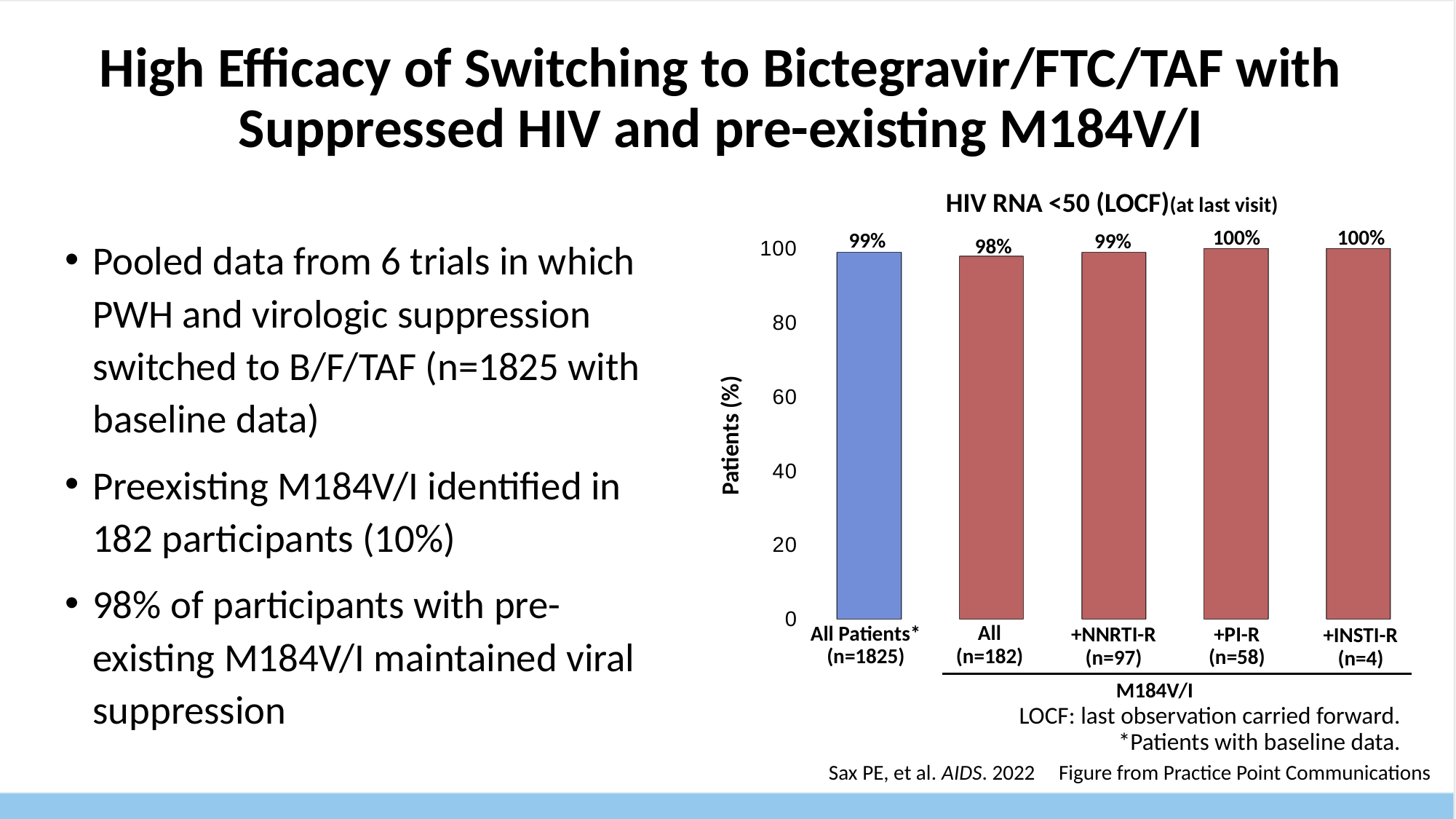
What is the value for the +INSTI-R (n=4) group? 100% Which category has the lowest value? All (n=182) What is the difference between the values for +PI-R (n=58) and All (n=182)? 2% What is the value for the +NNRTI-R (n=97) group? 99% What is the value for All Patients (n=1825)? 99% What is the value for the +PI-R (n=58) group? 100% What is the value for the All (n=182) M184V/I group? 98% Is the value for +NNRTI-R (n=97) greater or less than 80? greater How many bars are shown in the chart? 5 What kind of chart is shown on the slide? Bar chart Which is larger, the value for All Patients (n=1825) or the value for All (n=182)? All Patients (n=1825) What is the label of the y axis? Patients (%)